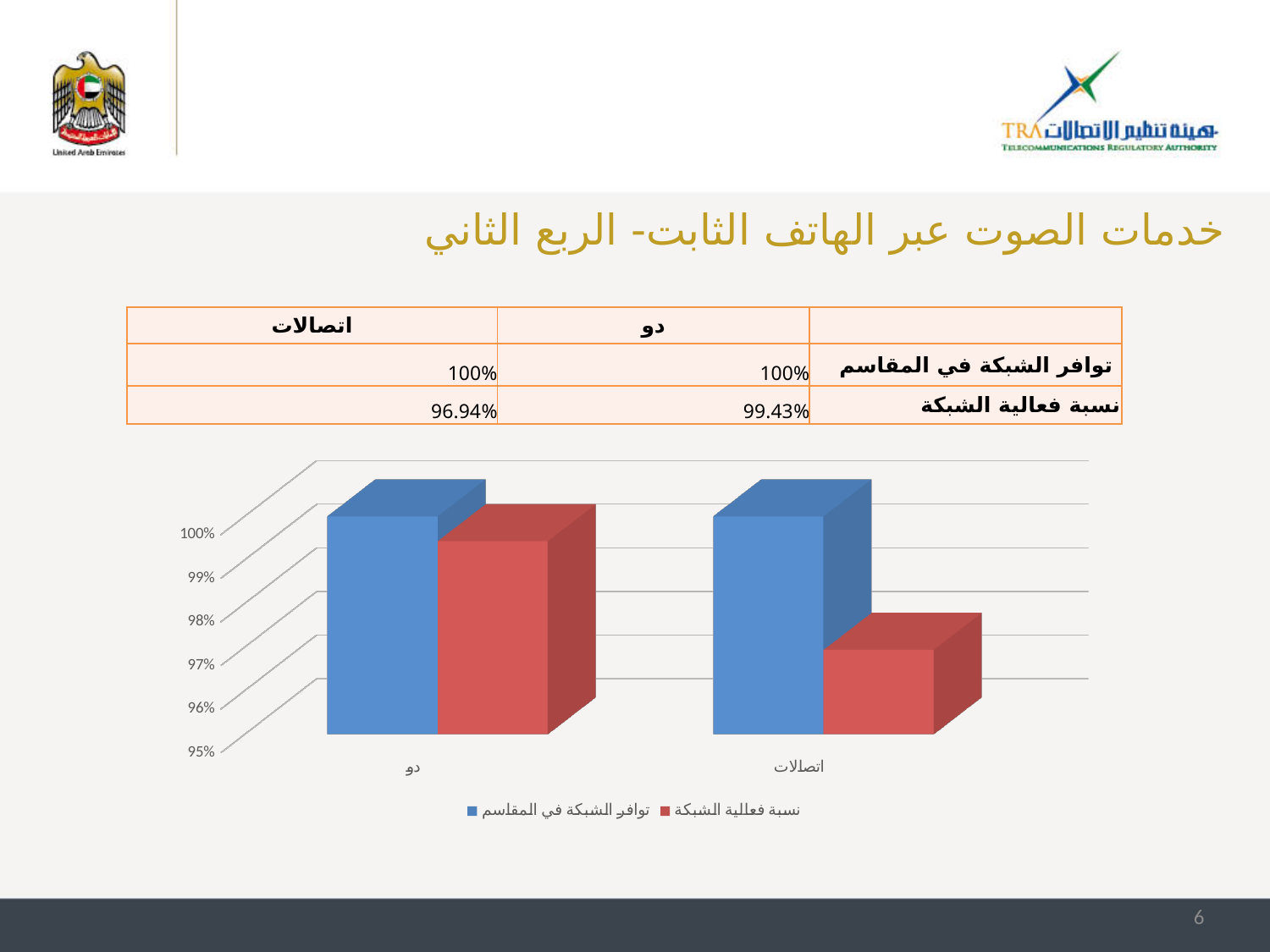
How many categories are shown on the x axis of the chart? 2 According to the table, what is the value of نسبة فعالية الشبكة for اتصالات? 96.94% How many series does the chart legend list? 2 According to the table, what is the value of نسبة فعالية الشبكة for دو? 99.43% In the chart, is the red bar for دو greater or less than 99%? greater Which operator has the higher نسبة فعالية الشبكة, دو or اتصالات? دو According to the table, what is the value of توافر الشبكة في المقاسم for دو? 100% What is the lowest value shown on the chart's vertical axis? 95% What is the difference between the نسبة فعالية الشبكة values of دو and اتصالات? 2.49% What type of chart is shown on the slide? bar chart According to the table, what is the value of توافر الشبكة في المقاسم for اتصالات? 100% In the chart, is the red bar for اتصالات greater or less than 98%? less